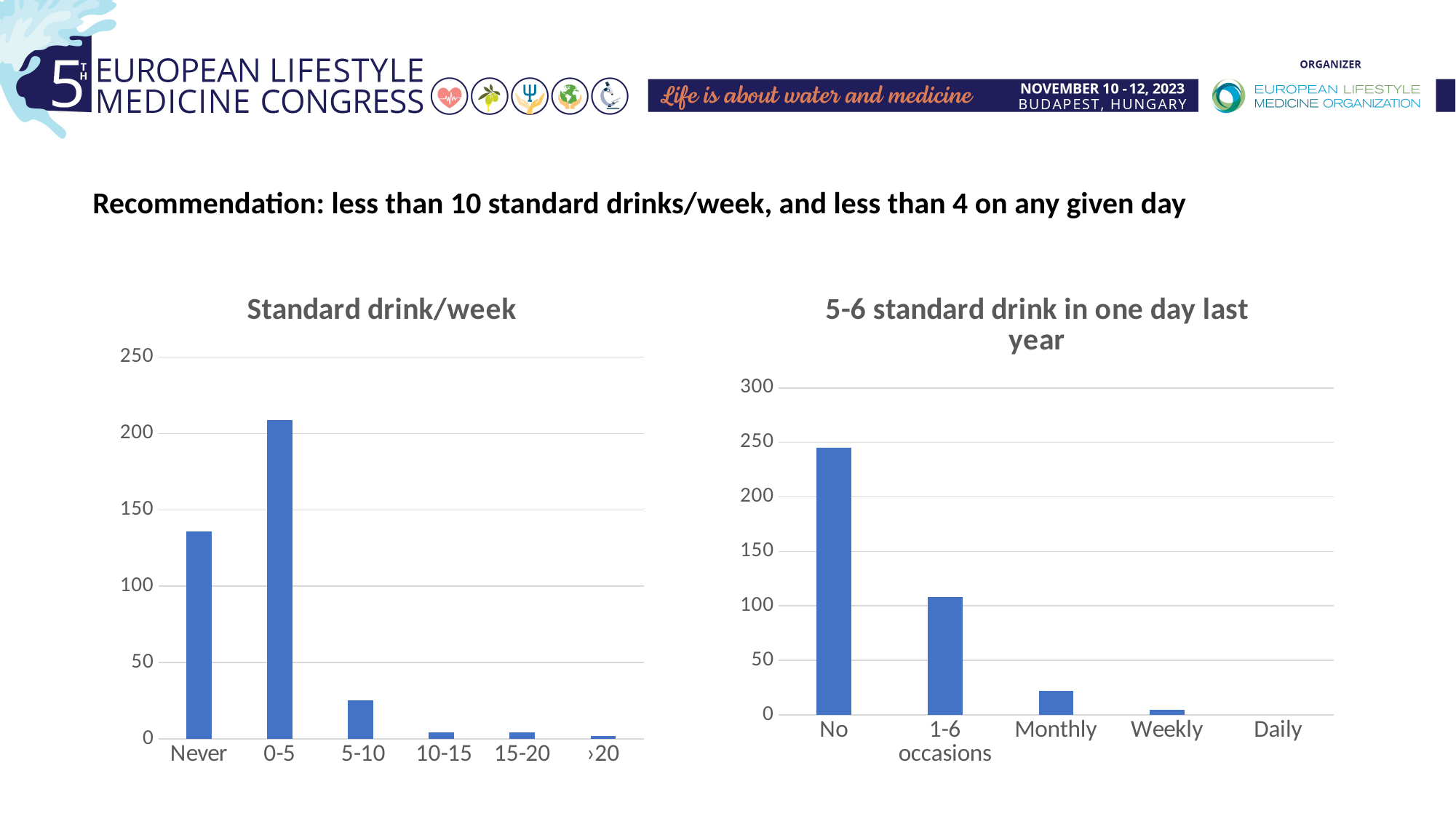
In the 'Standard drink/week' chart, is the value for Never greater or less than 100? greater In the 'Standard drink/week' chart, is the value for 5-10 greater or less than 50? less In the '5-6 standard drink in one day last year' chart, is the value for No greater or less than 200? greater In the '5-6 standard drink in one day last year' chart, which category has the highest bar? No In the 'Standard drink/week' chart, which is larger, the value for Never or the value for 0-5? 0-5 In the '5-6 standard drink in one day last year' chart, which category has the lowest bar? Daily In the '5-6 standard drink in one day last year' chart, how many categories are shown on the x axis? 5 What type of chart is the chart on the right of the slide? Bar chart In the 'Standard drink/week' chart, which category has the highest bar? 0-5 In the 'Standard drink/week' chart, how many categories are shown on the x axis? 6